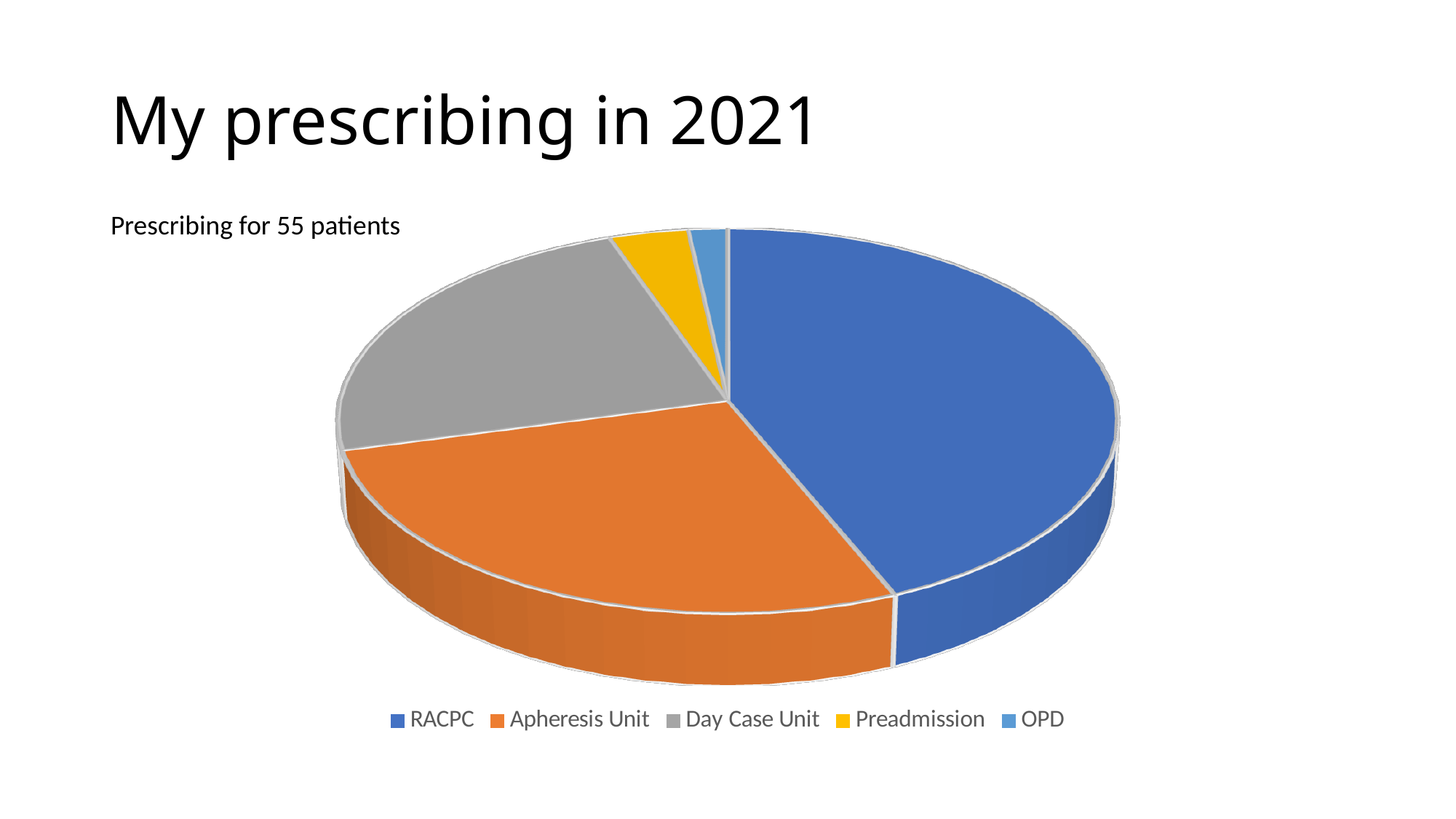
Which slice is larger, Apheresis Unit or Preadmission? Apheresis Unit Which slice is larger, RACPC or Day Case Unit? RACPC What is the title of the chart? Prescribing for 55 patients Which slice is larger, Day Case Unit or OPD? Day Case Unit How many categories does the pie chart show? 5 Which category is shown in orange? Apheresis Unit How many entries does the legend list? 5 Which category has the smallest slice of the pie? OPD What kind of chart is shown on the slide? Pie chart Which category has the largest slice of the pie? RACPC